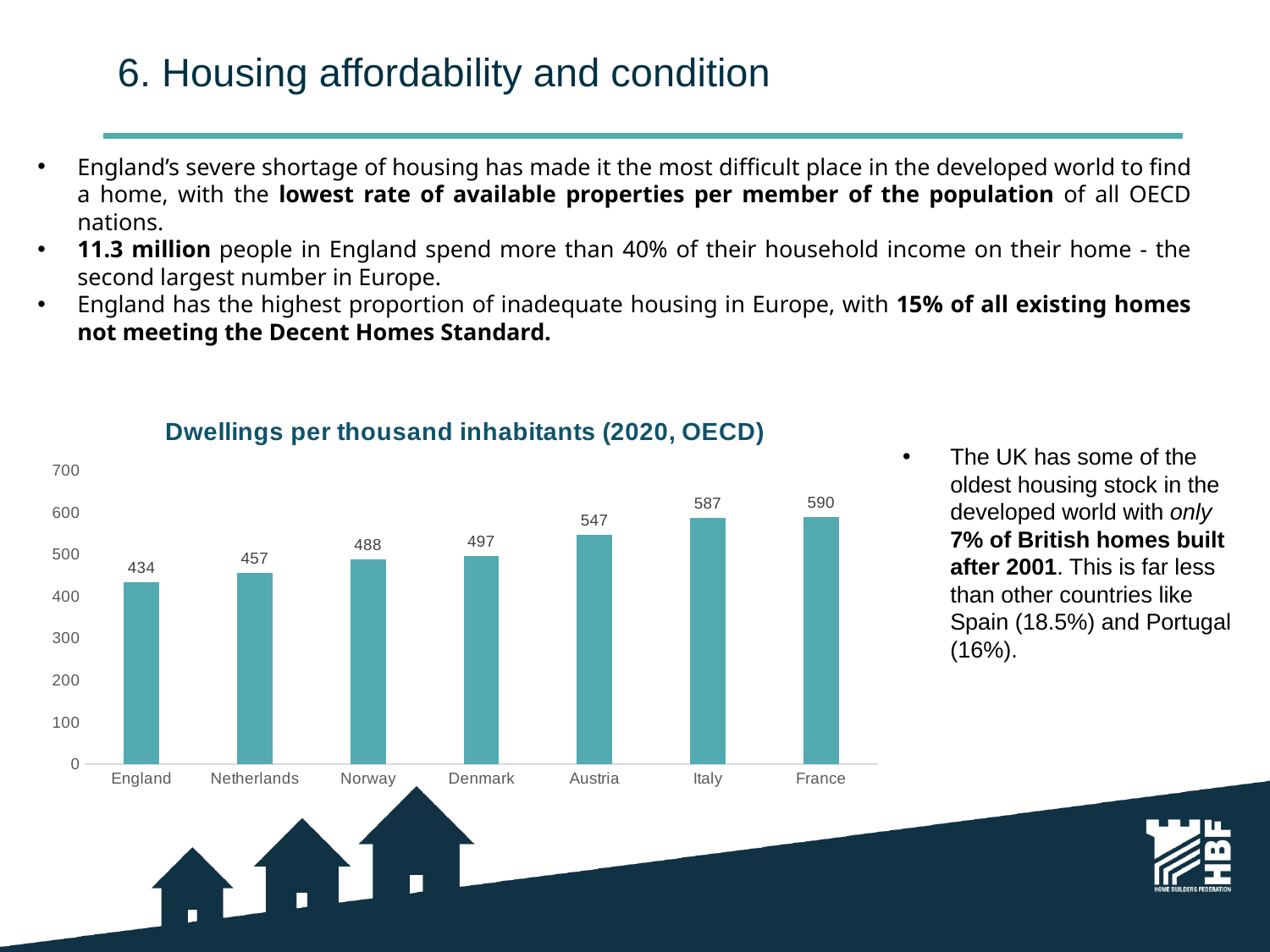
What is the value for Norway in the chart? 488 What is the difference between the values for France and England? 156 What is the difference between the values for Denmark and Netherlands? 40 What is the title of the chart? Dwellings per thousand inhabitants (2020, OECD) Which country has the lowest number of dwellings per thousand inhabitants? England Which country has the highest number of dwellings per thousand inhabitants? France What is the value for Austria in the chart? 547 What type of chart is shown on the slide? bar chart Which has a higher value, Italy or Austria? Italy Is the value for Netherlands greater or less than 500? less How many countries are shown in the chart? 7 What is the value for England in the chart? 434